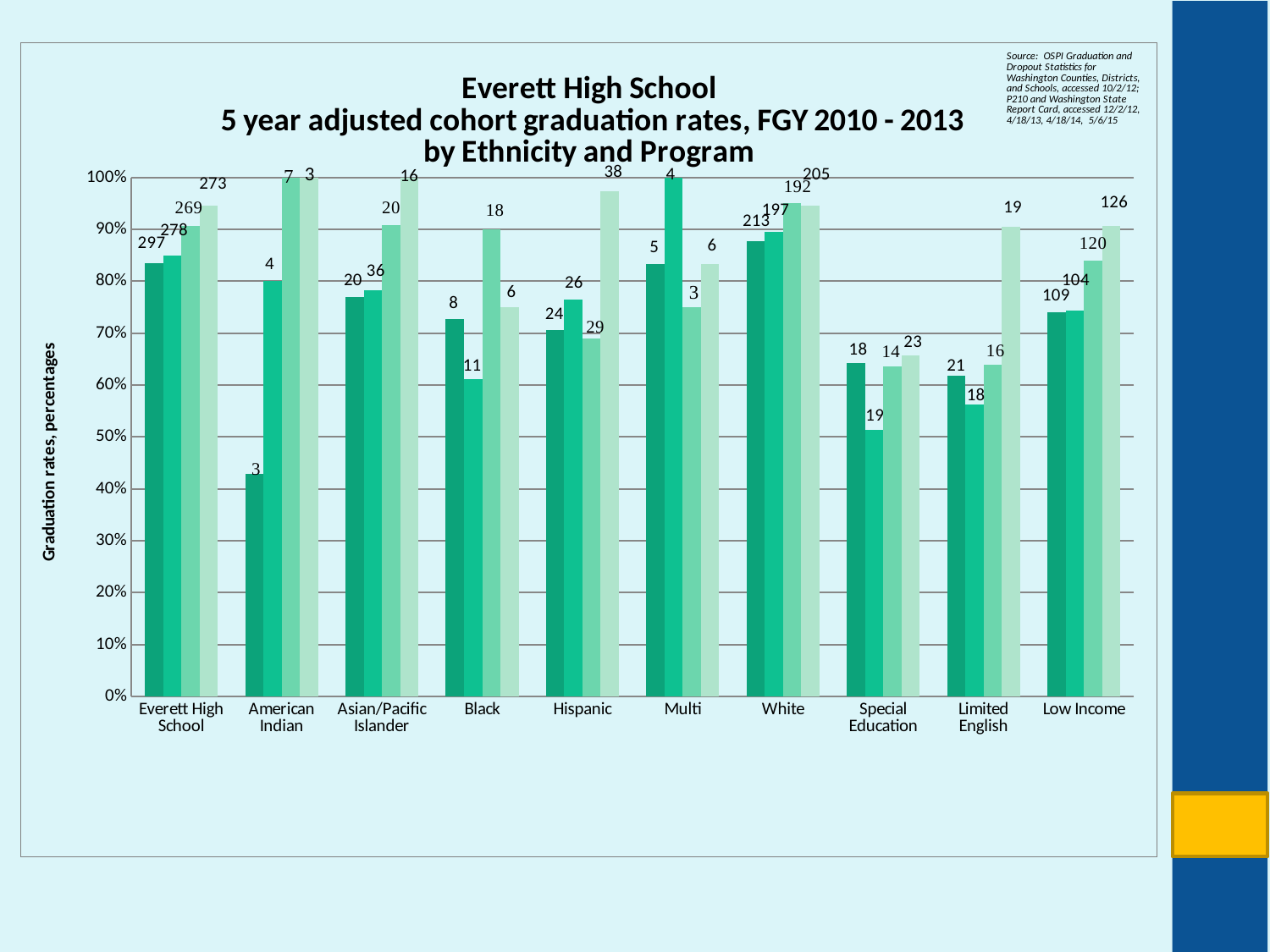
Is the value of the rightmost bar for Hispanic greater or less than 90%? greater Is the value of the second bar for Limited English greater or less than 60%? less Is the value of the leftmost bar for American Indian greater or less than 50%? less What kind of chart is shown on the slide? bar chart How many categories are shown along the x axis of the chart? 10 Which is larger, the leftmost bar for White or the leftmost bar for Special Education? White Which category has the lowest bar on the chart? American Indian What is the label on the vertical axis of the chart? Graduation rates, percentages Do the four bars for Everett High School rise or fall from left to right? rise How many bars are plotted for each category on the chart? 4 What is the highest value shown on the vertical axis of the chart? 100%